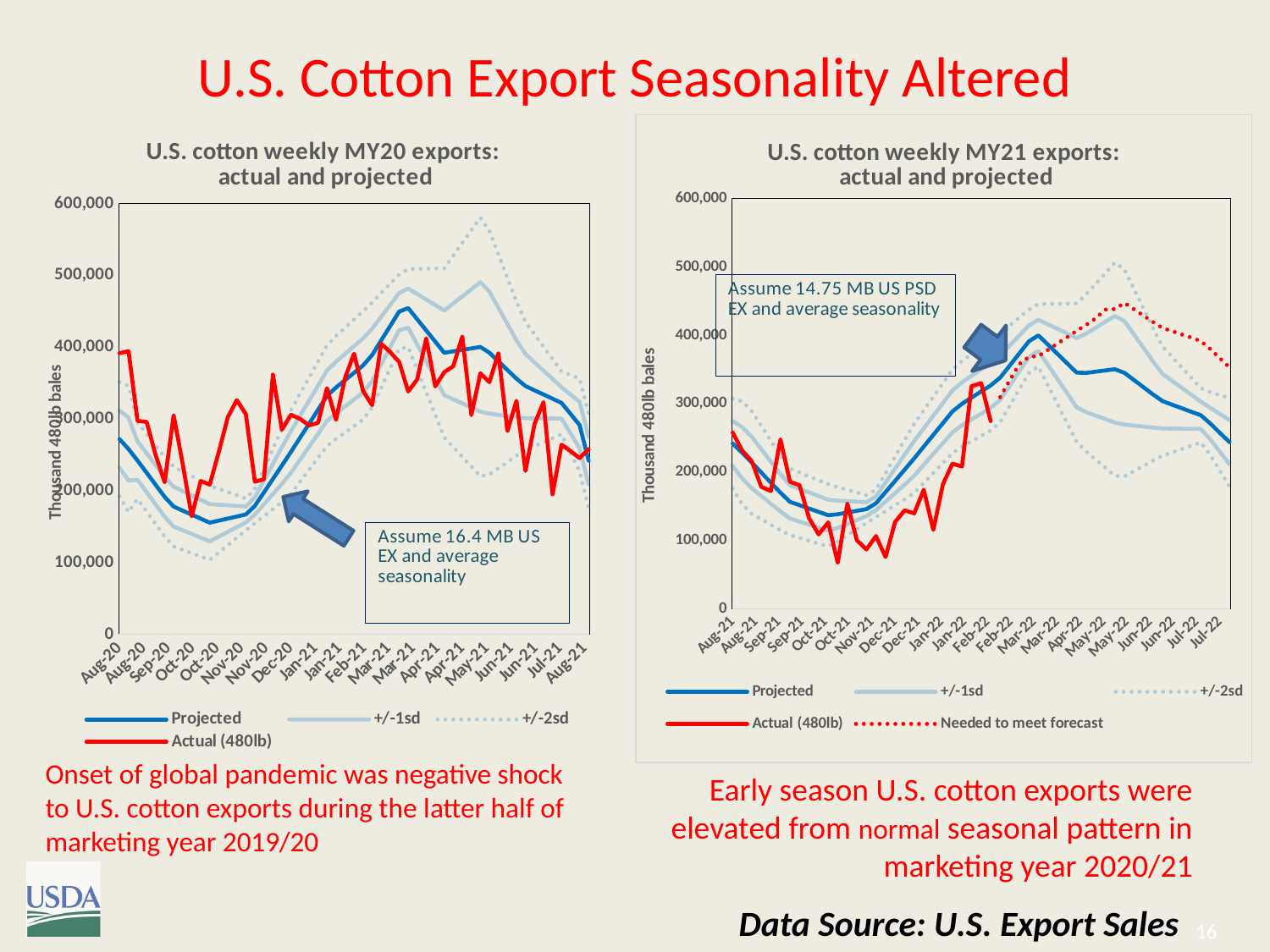
In the left chart (MY20 exports), is the peak of the Projected line greater or less than 400,000? greater What is the y-axis title of the right chart (MY21 exports)? Thousand 480lb bales In the right chart (MY21 exports), is the lowest Actual (480lb) value, around Oct-21, greater or less than 100,000? less How many series does the legend of the right chart ('U.S. cotton weekly MY21 exports') list? 5 In the right chart (MY21 exports), does the 'Needed to meet forecast' line rise or fall from May-22 to Jul-22? Fall In the left chart (MY20 exports), in which month does the Projected line reach its highest value? Mar-21 How many series does the legend of the left chart ('U.S. cotton weekly MY20 exports') list? 4 What kind of chart is the left chart titled 'U.S. cotton weekly MY20 exports: actual and projected'? Line chart In the left chart (MY20 exports), does the Projected line rise or fall from Aug-20 to Oct-20? Fall In the right chart (MY21 exports), is the lowest point of the Projected line greater or less than 200,000? less